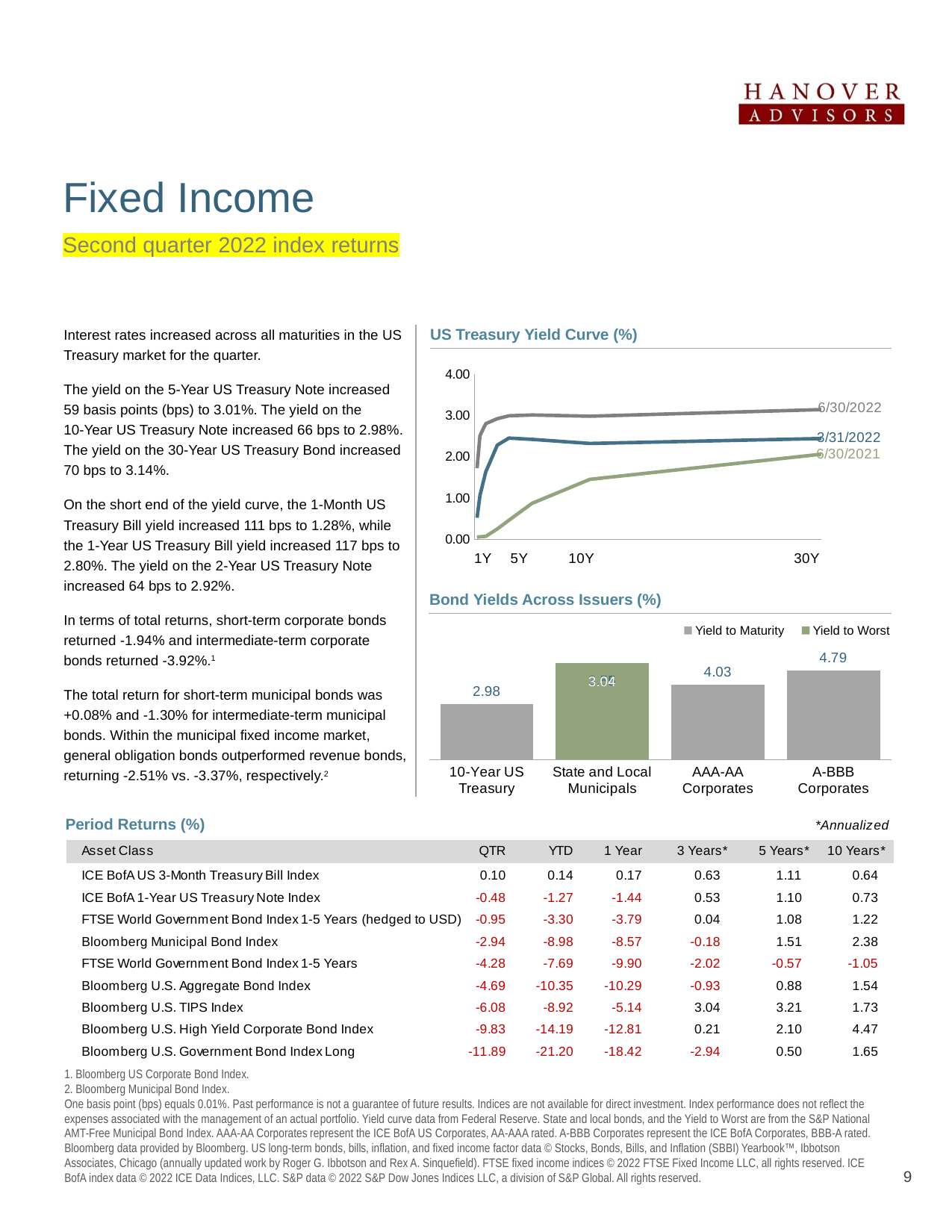
In the "Bond Yields Across Issuers (%)" chart, what is the value for AAA-AA Corporates? 4.03 What kind of chart is the "US Treasury Yield Curve (%)" chart? line chart In the "Bond Yields Across Issuers (%)" chart, what is the difference between A-BBB Corporates and 10-Year US Treasury? 1.81 In the "Bond Yields Across Issuers (%)" chart, how many entries does the legend list? 2 In the "Bond Yields Across Issuers (%)" chart, what is the value for State and Local Municipals? 3.04 In the "US Treasury Yield Curve (%)" chart, how many series are plotted? 3 In the "Bond Yields Across Issuers (%)" chart, which category has the lowest value? 10-Year US Treasury In the "Bond Yields Across Issuers (%)" chart, which category has the highest value? A-BBB Corporates In the "US Treasury Yield Curve (%)" chart, is the 6/30/2021 value at 1Y greater or less than 1.00? less In the "Bond Yields Across Issuers (%)" chart, how many categories are shown? 4 What kind of chart is the "Bond Yields Across Issuers (%)" chart? bar chart In the "US Treasury Yield Curve (%)" chart, do the 6/30/2021 values rise or fall from 1Y to 30Y? rise